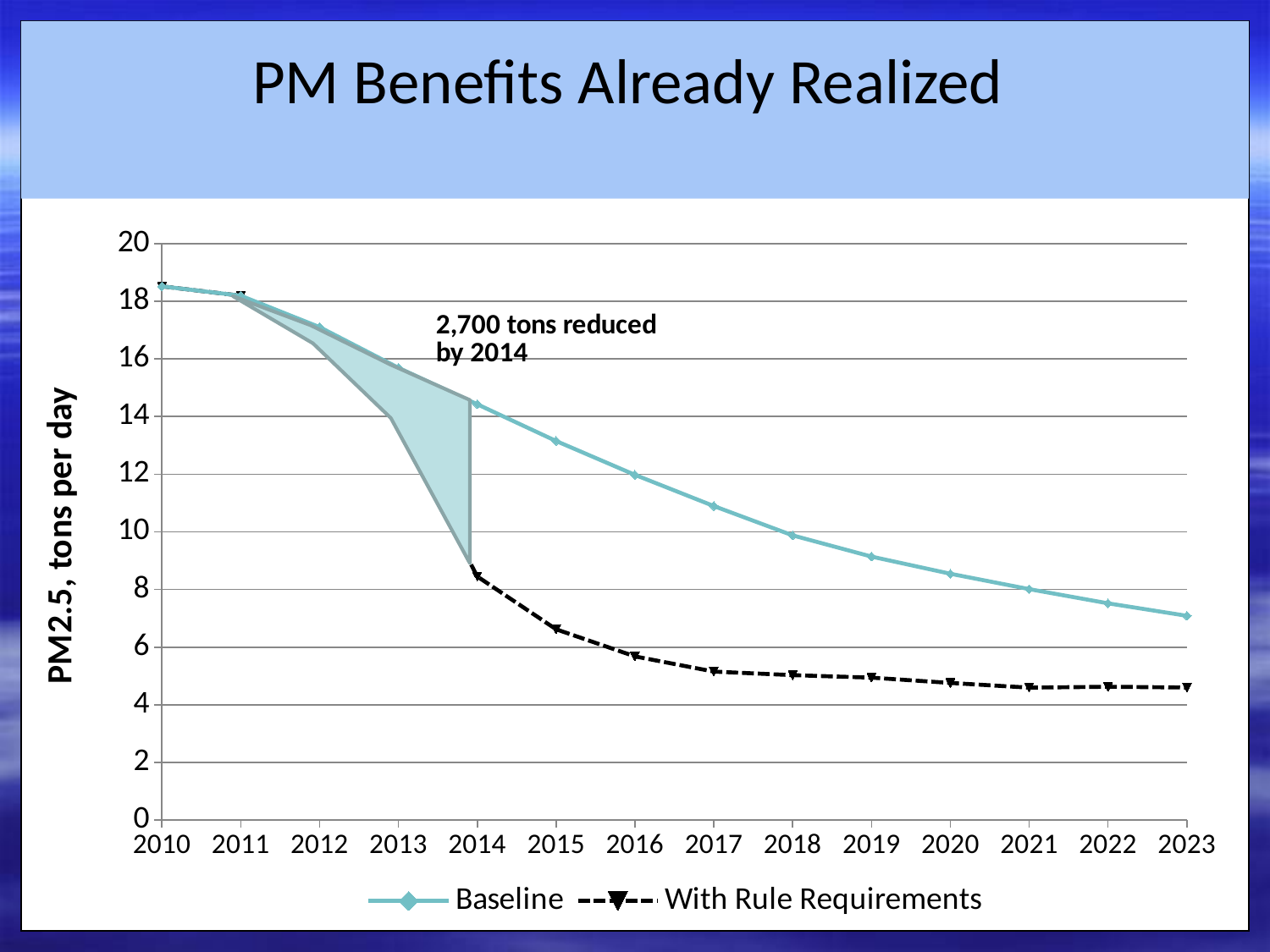
How many years are plotted along the x axis? 14 What is the label on the y axis of the chart? PM2.5, tons per day In which year is the Baseline series at its highest? 2010 In which year is the Baseline series at its lowest? 2023 Is the With Rule Requirements value for 2015 greater or less than 6? greater Is the Baseline value for 2010 greater or less than 18? greater Is the Baseline value for 2023 greater or less than 8? less Does the Baseline series rise or fall from 2010 to 2023? Fall What kind of chart is shown on the slide? Line chart How many series does the legend list? 2 In 2014, which series has the higher value, Baseline or With Rule Requirements? Baseline